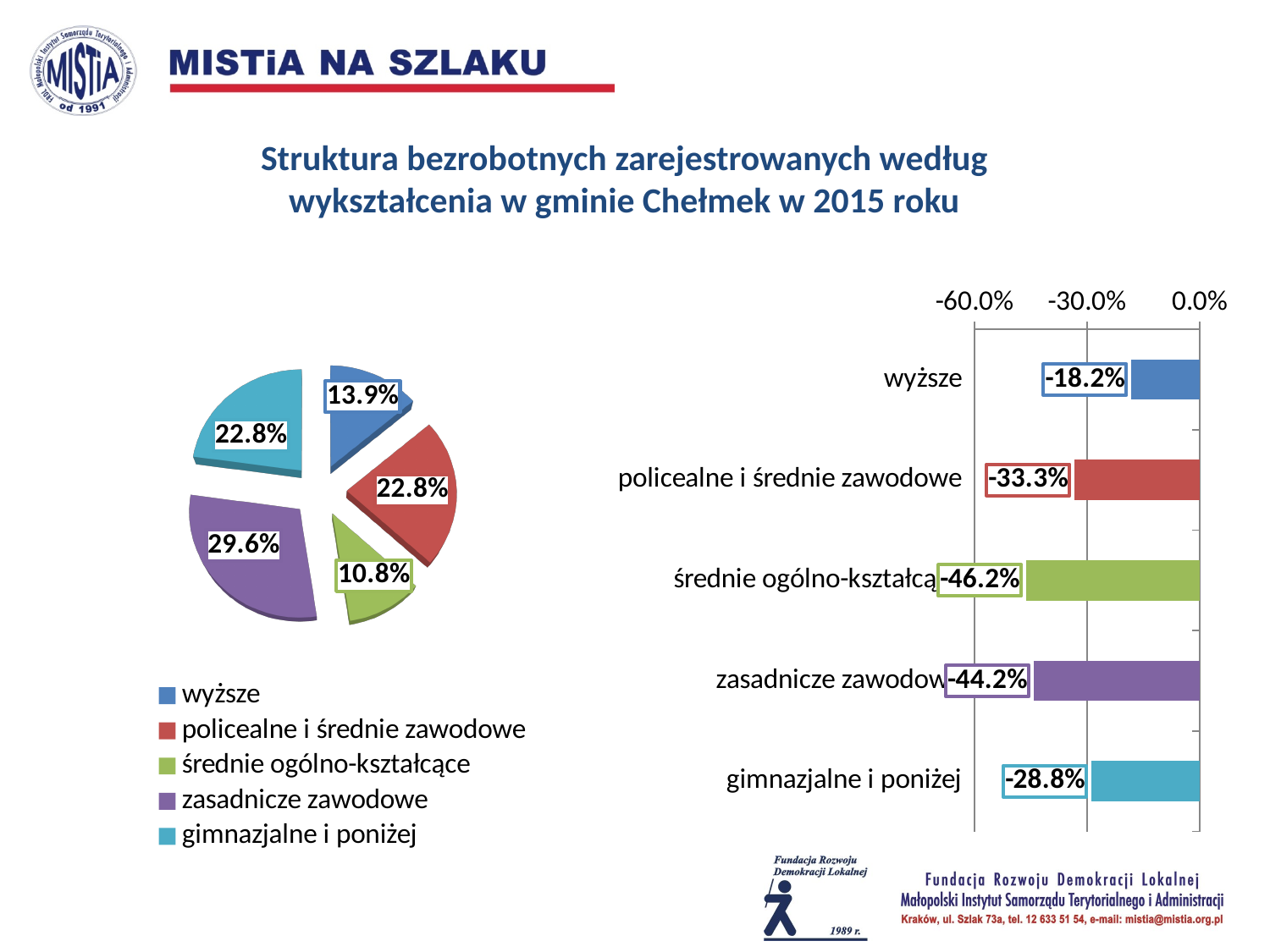
In the bar chart on the right, what is the value for średnie ogólno-kształcące? -46.2% In the bar chart on the right, what is the value for gimnazjalne i poniżej? -28.8% In the bar chart on the right, what is the difference between the values for wyższe and policealne i średnie zawodowe? 15.1% In the pie chart on the left, how many slices are there? 5 In the pie chart on the left, what is the difference between the shares of zasadnicze zawodowe and średnie ogólno-kształcące? 18.8% In the pie chart on the left, which category has the smallest slice? średnie ogólno-kształcące In the bar chart on the right, which category has the highest (least negative) value? wyższe In the pie chart on the left, what share does zasadnicze zawodowe have? 29.6% What type of chart is shown on the right side of the slide? bar chart In the pie chart on the left, what share does wyższe have? 13.9% In the pie chart on the left, which category has the largest slice? zasadnicze zawodowe In the bar chart on the right, which category has the lowest (most negative) value? średnie ogólno-kształcące